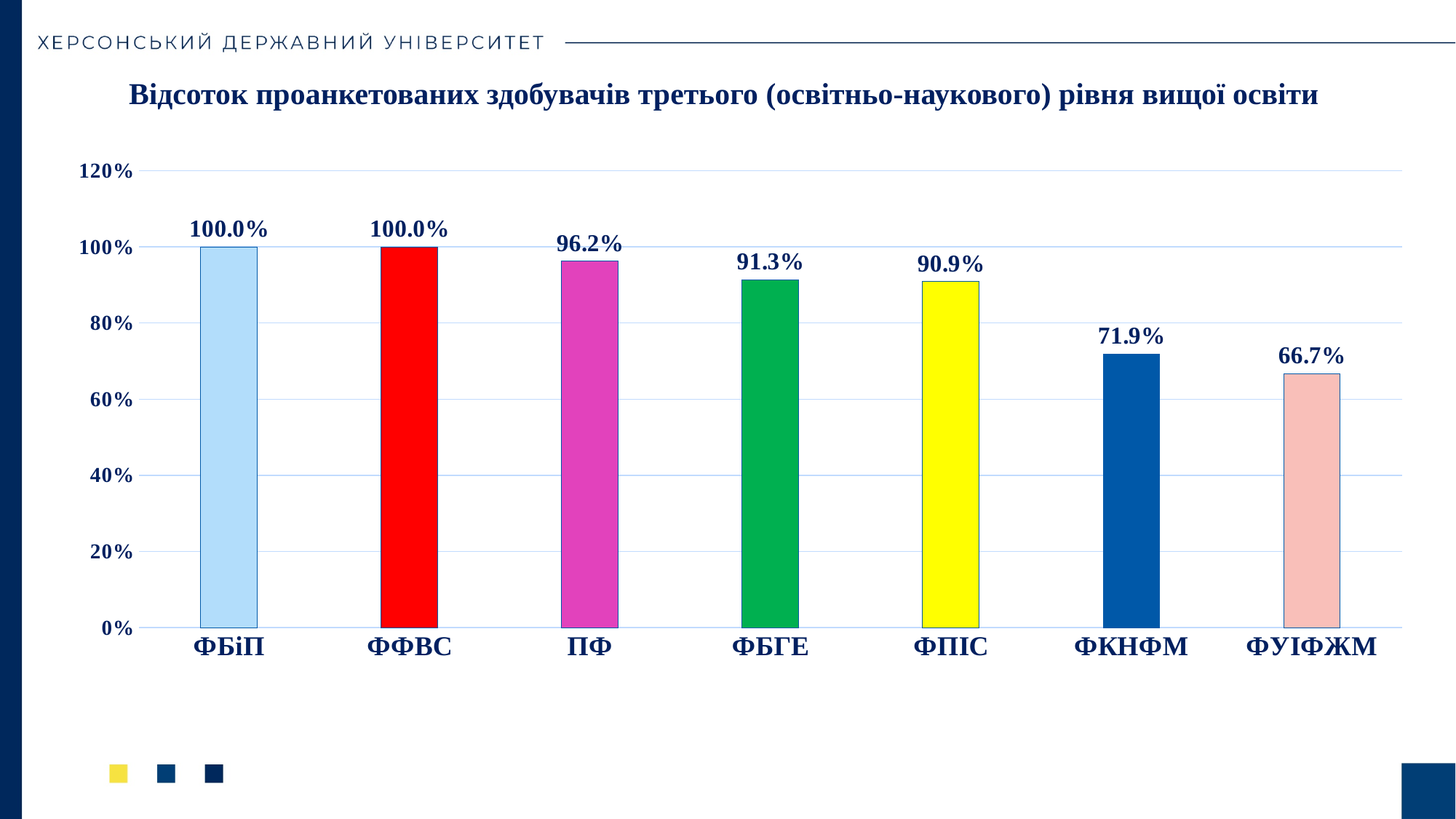
Do the values rise or fall from left to right along the x axis? fall What is the value for ФПІС? 90.9% Which category has the lowest value? ФУІФЖМ How many categories are shown on the x axis? 7 What is the difference between the values for ФБГЕ and ФУІФЖМ? 24.6% Which is larger, the value for ПФ or the value for ФКНФМ? ПФ What kind of chart is shown on the slide? bar chart What is the title of the chart? Відсоток проанкетованих здобувачів третього (освітньо-наукового) рівня вищої освіти What is the value for ФКНФМ? 71.9% Is the value for ФУІФЖМ greater or less than 80%? less What is the value for ПФ? 96.2% What is the difference between the values for ФФВС and ФКНФМ? 28.1%